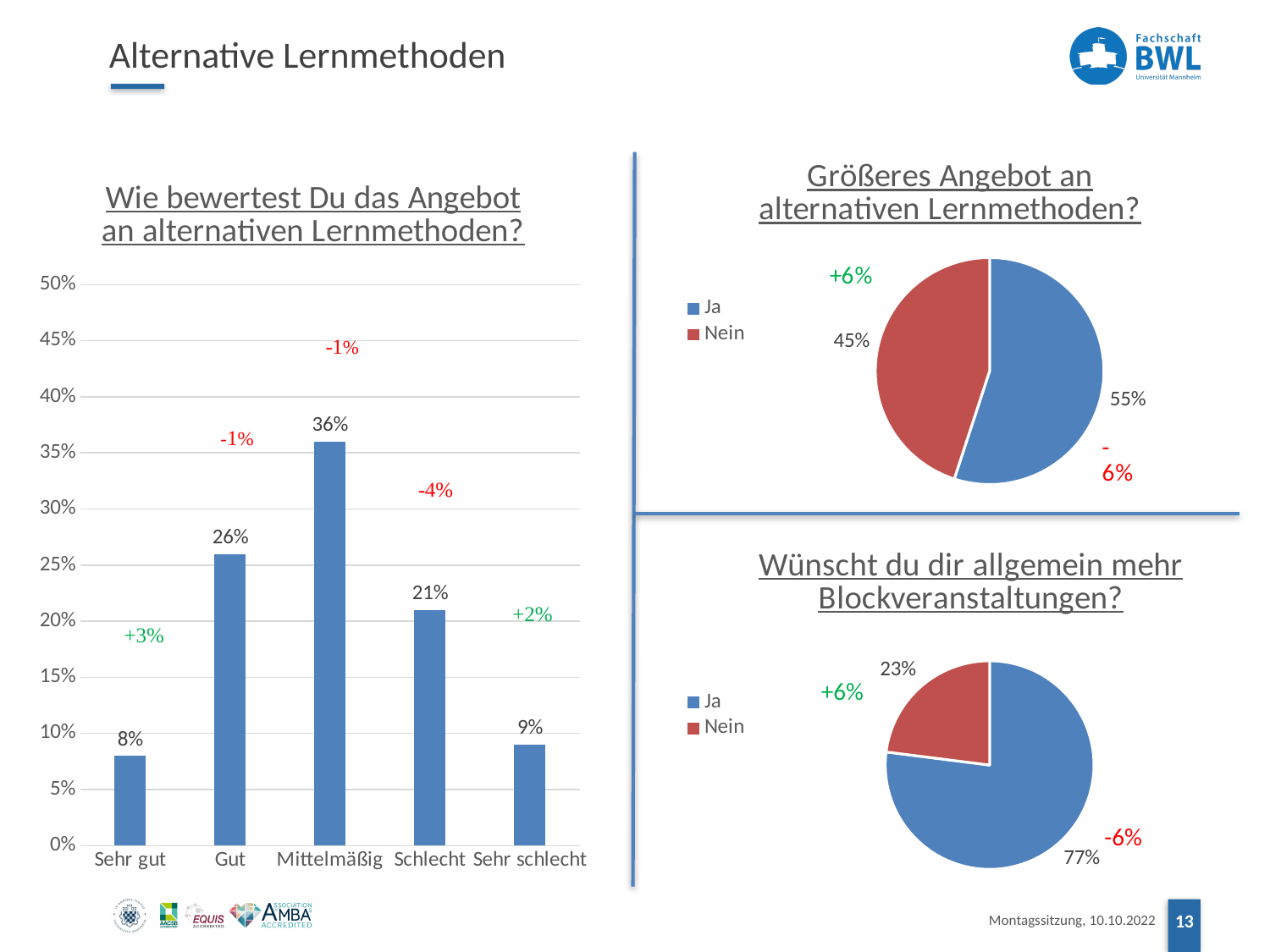
What kind of chart is 'Wie bewertest Du das Angebot an alternativen Lernmethoden?'? Bar chart In the pie chart 'Wünscht du dir allgemein mehr Blockveranstaltungen?', what share is Nein? 23% In the pie chart 'Größeres Angebot an alternativen Lernmethoden?', what share is Nein? 45% In the pie chart 'Größeres Angebot an alternativen Lernmethoden?', what share is Ja? 55% In the bar chart 'Wie bewertest Du das Angebot an alternativen Lernmethoden?', which is larger, Gut or Sehr schlecht? Gut In the bar chart 'Wie bewertest Du das Angebot an alternativen Lernmethoden?', which category has the lowest value? Sehr gut In the bar chart 'Wie bewertest Du das Angebot an alternativen Lernmethoden?', what is the difference between Gut and Schlecht? 5% In the bar chart 'Wie bewertest Du das Angebot an alternativen Lernmethoden?', what is the value for Sehr gut? 8% How many series does the legend of the pie chart 'Wünscht du dir allgemein mehr Blockveranstaltungen?' list? 2 In the bar chart 'Wie bewertest Du das Angebot an alternativen Lernmethoden?', what is the value for Mittelmäßig? 36% In the bar chart 'Wie bewertest Du das Angebot an alternativen Lernmethoden?', which category has the highest value? Mittelmäßig How many categories are shown in the bar chart 'Wie bewertest Du das Angebot an alternativen Lernmethoden?'? 5